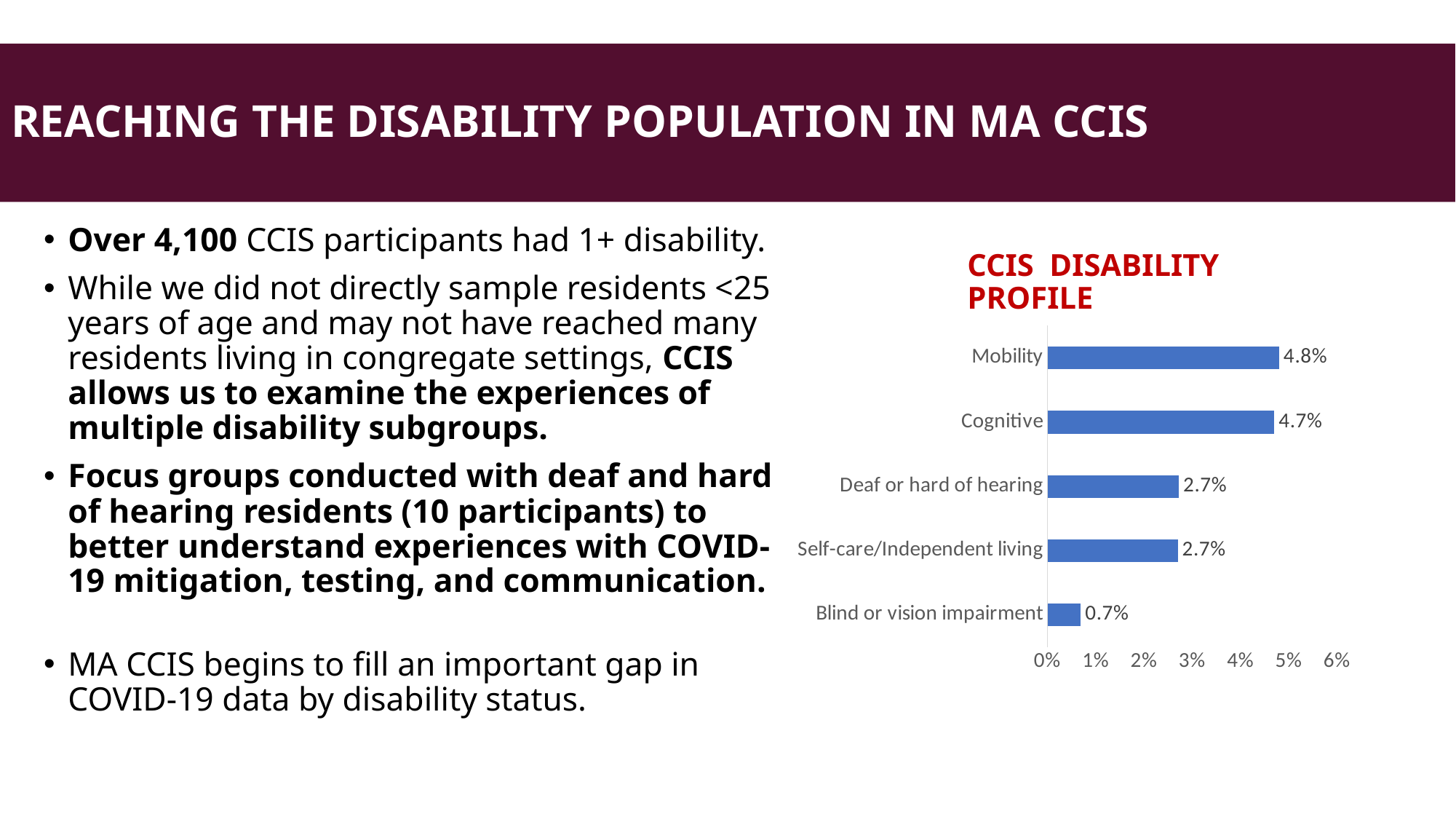
Which category has the highest value in the CCIS Disability Profile chart? Mobility Which is larger in the CCIS Disability Profile chart, Cognitive or Self-care/Independent living? Cognitive What is the value for Blind or vision impairment in the CCIS Disability Profile chart? 0.7% What is the title of the chart on the slide? CCIS Disability Profile What kind of chart is the CCIS Disability Profile? Bar chart What is the value for Mobility in the CCIS Disability Profile chart? 4.8% What is the difference between the Mobility and Blind or vision impairment values in the CCIS Disability Profile chart? 4.1% What is the value for Cognitive in the CCIS Disability Profile chart? 4.7% How many categories are shown in the CCIS Disability Profile chart? 5 What is the difference between the Cognitive and Deaf or hard of hearing values in the CCIS Disability Profile chart? 2.0% What is the value for Deaf or hard of hearing in the CCIS Disability Profile chart? 2.7% Which category has the lowest value in the CCIS Disability Profile chart? Blind or vision impairment